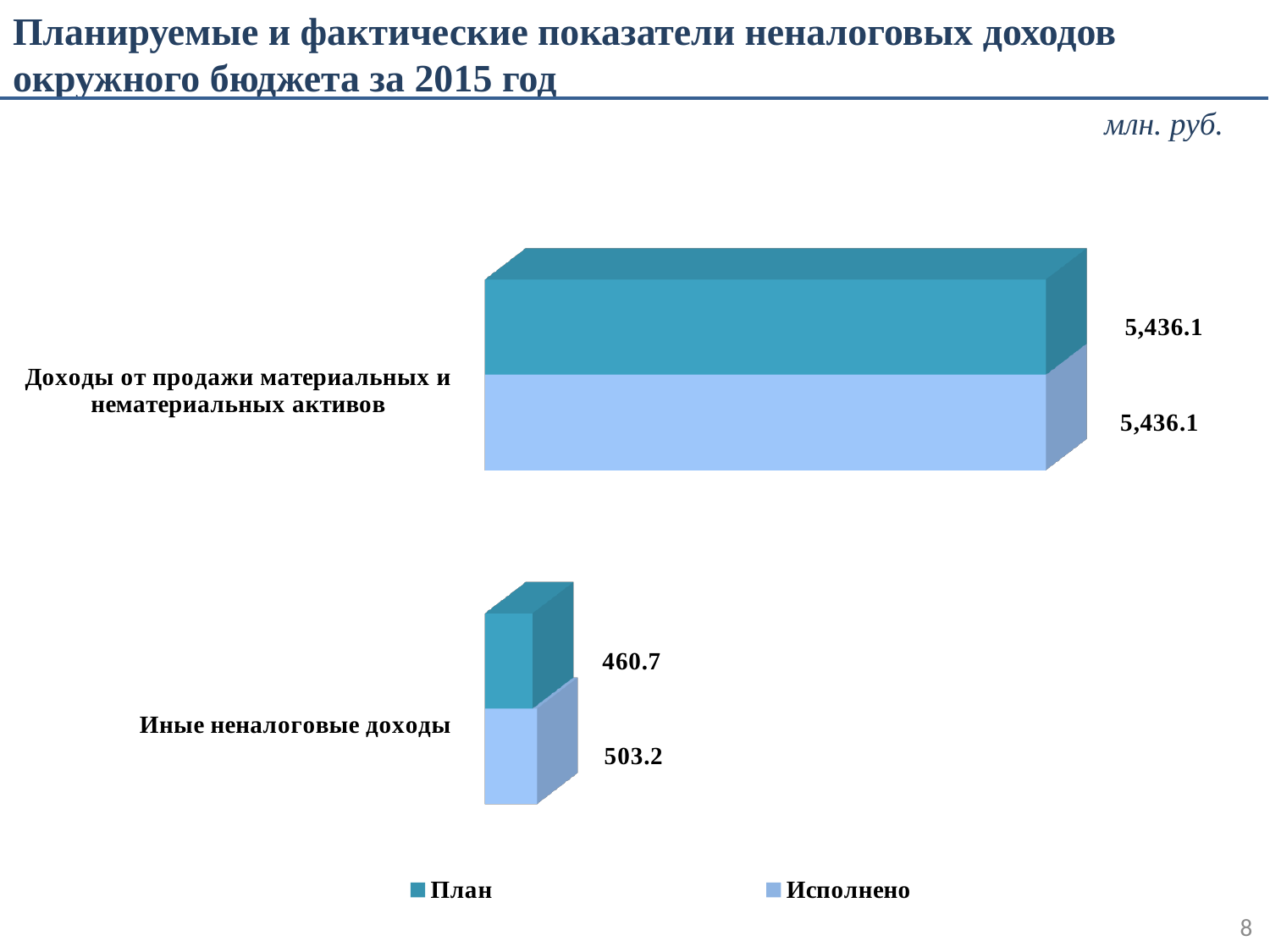
For Иные неналоговые доходы, which is larger: План or Исполнено? Исполнено How many series does the legend list? 2 What is the Исполнено value for Иные неналоговые доходы? 503.2 What unit of measurement is indicated for the chart values? млн. руб. Which category has the highest Исполнено value? Доходы от продажи материальных и нематериальных активов What is the difference between the Исполнено and План values for Иные неналоговые доходы? 42.5 Which category has the lowest План value? Иные неналоговые доходы What is the План value for Доходы от продажи материальных и нематериальных активов? 5,436.1 What is the План value for Иные неналоговые доходы? 460.7 What is the Исполнено value for Доходы от продажи материальных и нематериальных активов? 5,436.1 What kind of chart is shown on the slide? Bar chart How many categories are shown in the chart? 2